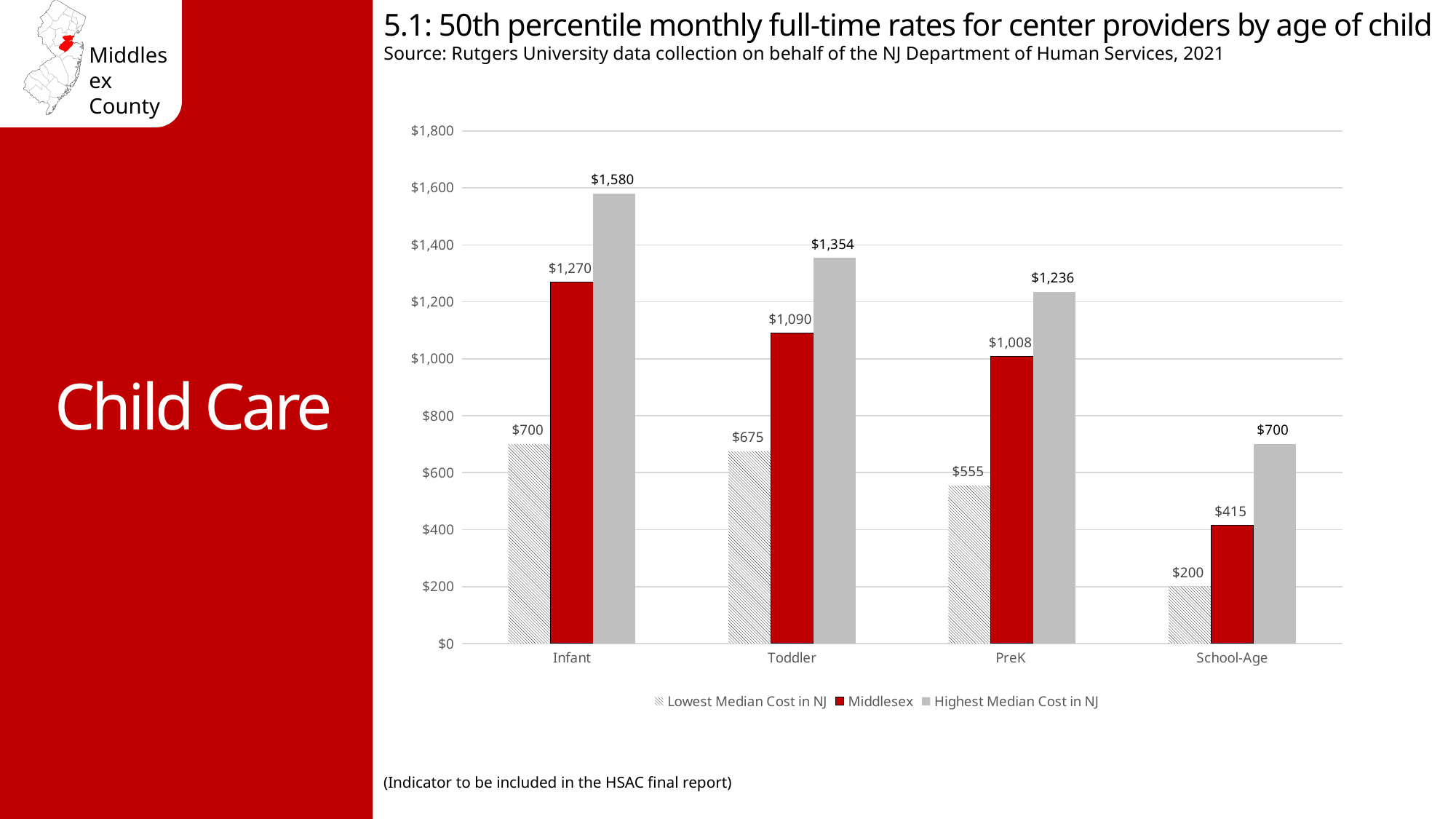
How many age groups are shown on the x axis? 4 How many series does the legend list? 3 Which age group has the lowest Highest Median Cost in NJ value? School-Age Is the Middlesex value for School-Age greater or less than $400? greater What is the Highest Median Cost in NJ for Toddler? $1,354 What is the Lowest Median Cost in NJ for School-Age? $200 What is the difference between the Highest Median Cost in NJ and the Middlesex value for PreK? $228 Which is larger: the Middlesex value for Toddler or the Middlesex value for PreK? Toddler What kind of chart is shown? bar chart Which age group has the highest Middlesex value? Infant What is the Middlesex value for Infant? $1,270 Do the Middlesex values rise or fall from Infant to School-Age? fall